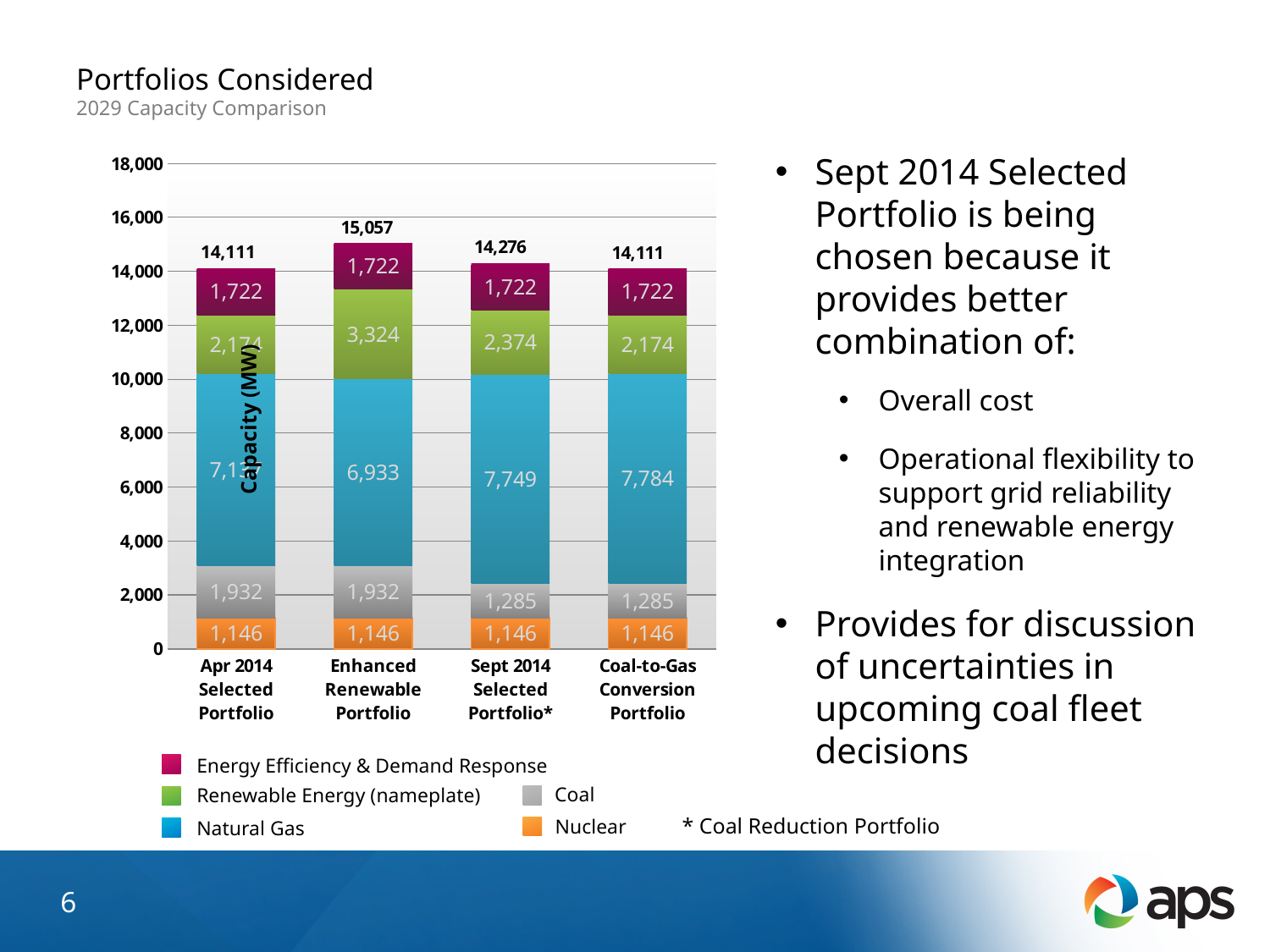
Which has more Coal capacity, the Apr 2014 Selected Portfolio or the Sept 2014 Selected Portfolio*? Apr 2014 Selected Portfolio What kind of chart is shown on the slide? Stacked bar chart What is the difference in Natural Gas capacity between the Coal-to-Gas Conversion Portfolio and the Sept 2014 Selected Portfolio*? 35 What is the label on the vertical axis of the chart? Capacity (MW) Which portfolio has the highest total capacity? Enhanced Renewable Portfolio By how much does the total capacity of the Enhanced Renewable Portfolio exceed that of the Sept 2014 Selected Portfolio*? 781 What is the total capacity of the Enhanced Renewable Portfolio bar? 15,057 What is the Nuclear capacity for the Coal-to-Gas Conversion Portfolio? 1,146 What is the Natural Gas capacity for the Sept 2014 Selected Portfolio*? 7,749 How many series does the chart legend list? 5 What is the Renewable Energy (nameplate) capacity for the Enhanced Renewable Portfolio? 3,324 How many portfolios are compared on the x axis of the chart? 4